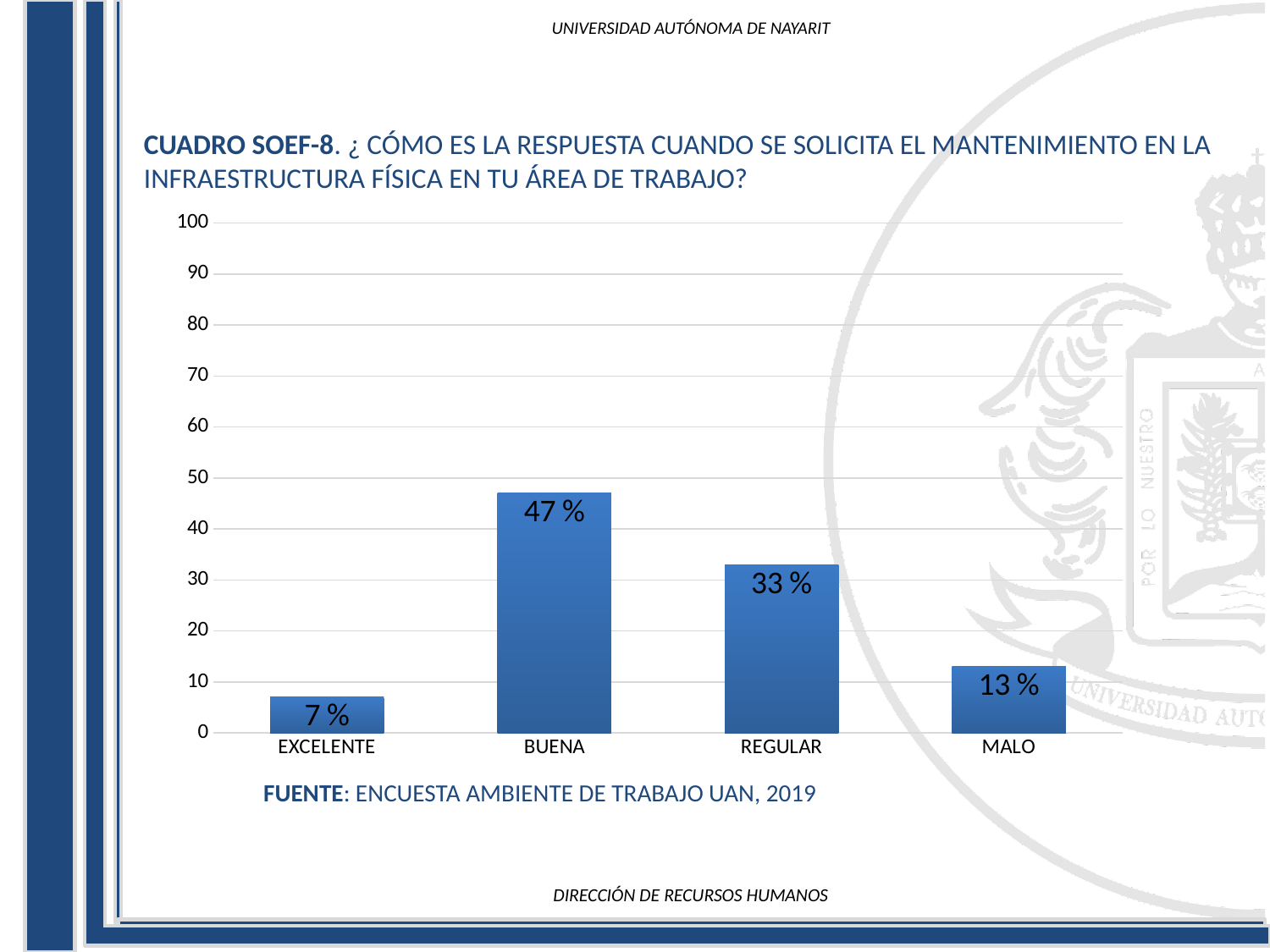
What is the difference between the values for BUENA and REGULAR? 14 % Is the value for BUENA greater or less than 40? greater What is the value for MALO? 13 % What is the value for EXCELENTE? 7 % Which category has the highest value? BUENA Which is larger, the value for REGULAR or the value for MALO? REGULAR What is the difference between the values for MALO and EXCELENTE? 6 % What is the value for BUENA? 47 % How many categories are shown on the x axis? 4 Which category has the lowest value? EXCELENTE What kind of chart is shown on the slide? bar chart What is the value for REGULAR? 33 %